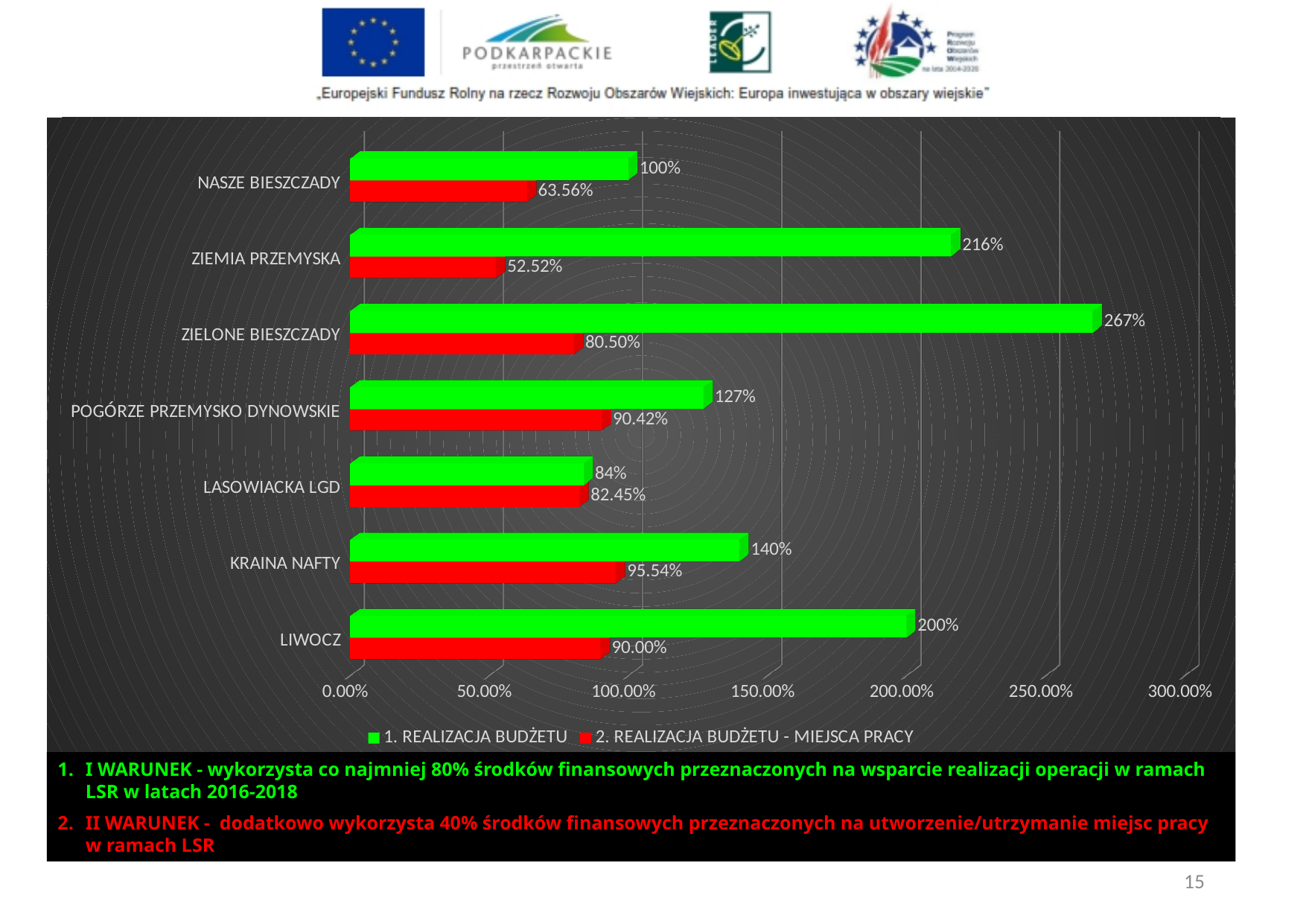
What is the value of 2. REALIZACJA BUDŻETU - MIEJSCA PRACY for ZIEMIA PRZEMYSKA? 52.52% What is the value of 1. REALIZACJA BUDŻETU for ZIELONE BIESZCZADY? 267% How many series does the legend list? 2 Which category has the lowest value for 1. REALIZACJA BUDŻETU? LASOWIACKA LGD What kind of chart is shown on the slide? Bar chart Which is larger: the 2. REALIZACJA BUDŻETU - MIEJSCA PRACY value for POGÓRZE PRZEMYSKO DYNOWSKIE or for NASZE BIESZCZADY? POGÓRZE PRZEMYSKO DYNOWSKIE What is the difference between the 1. REALIZACJA BUDŻETU values for LIWOCZ and NASZE BIESZCZADY? 100% Which colour represents the series 2. REALIZACJA BUDŻETU - MIEJSCA PRACY? Red How many categories are shown on the chart? 7 Which category has the lowest value for 2. REALIZACJA BUDŻETU - MIEJSCA PRACY? ZIEMIA PRZEMYSKA What is the value of 2. REALIZACJA BUDŻETU - MIEJSCA PRACY for KRAINA NAFTY? 95.54% Which category has the highest value for 1. REALIZACJA BUDŻETU? ZIELONE BIESZCZADY